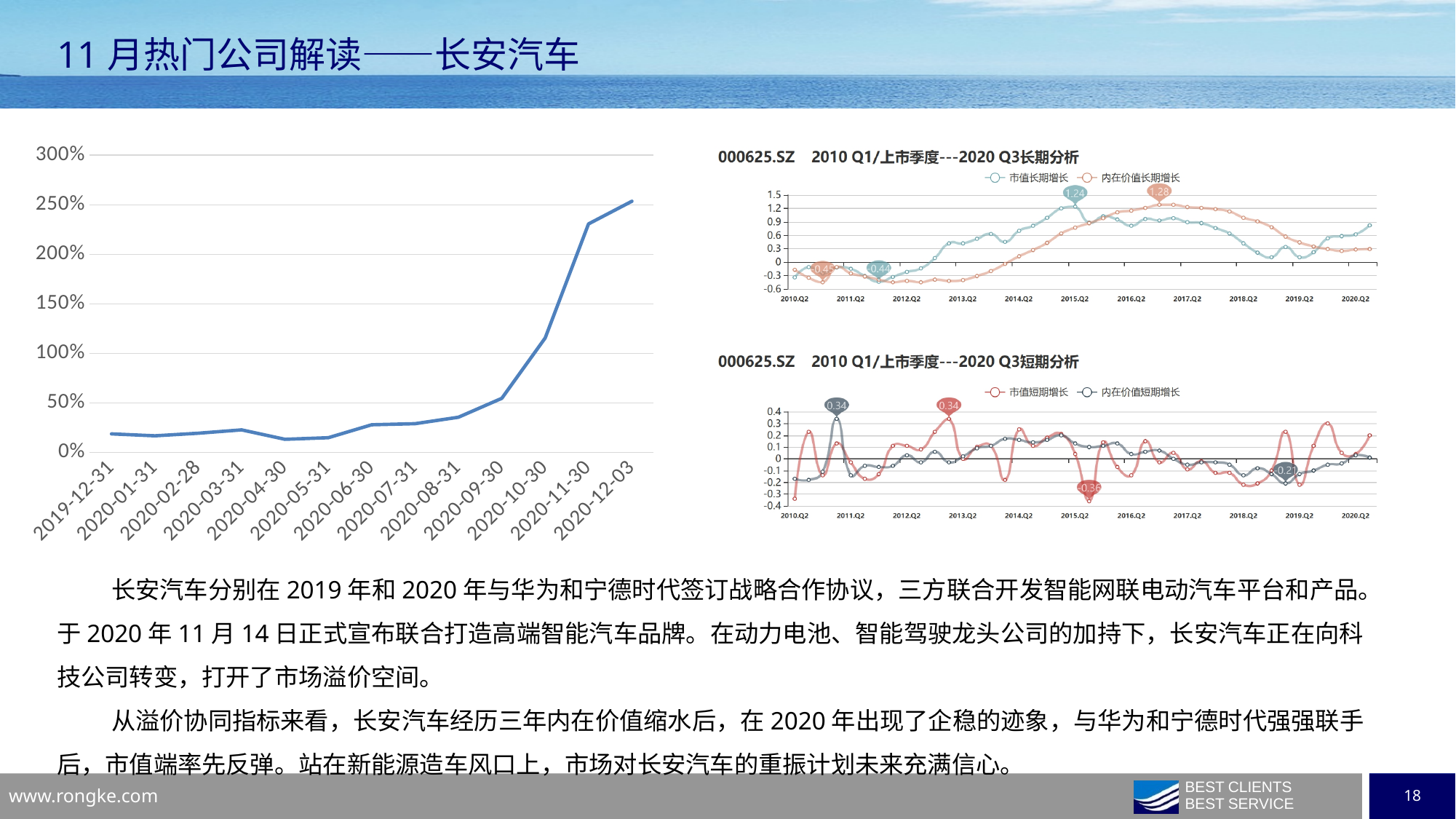
In the large line chart on the left, is the value for 2020-11-30 greater or less than 200%? greater In the large line chart on the left, is the value for 2020-09-30 greater or less than 100%? less What kind of chart is the large chart on the left of the slide? line chart In the chart titled '000625.SZ 2010 Q1/上市季度---2020 Q3长期分析', which series has the higher labelled peak, 市值长期增长 (1.24) or 内在价值长期增长 (1.28)? 内在价值长期增长 In the large line chart on the left, is the value for 2020-10-30 greater or less than 100%? greater In the large line chart on the left, do the values generally rise or fall from 2020-06-30 to 2020-12-03? rise How many dates are plotted along the x axis of the large line chart on the left? 13 In the chart titled '000625.SZ 2010 Q1/上市季度---2020 Q3长期分析', what is the labelled peak value of the 内在价值长期增长 series? 1.28 How many series does the legend of the chart titled '000625.SZ 2010 Q1/上市季度---2020 Q3长期分析' list? 2 In the chart titled '000625.SZ 2010 Q1/上市季度---2020 Q3短期分析', what is the lowest labelled value shown? -0.36 What are the two legend entries of the chart titled '000625.SZ 2010 Q1/上市季度---2020 Q3短期分析'? 市值短期增长 and 内在价值短期增长 In the large line chart on the left, which date has the highest value? 2020-12-03